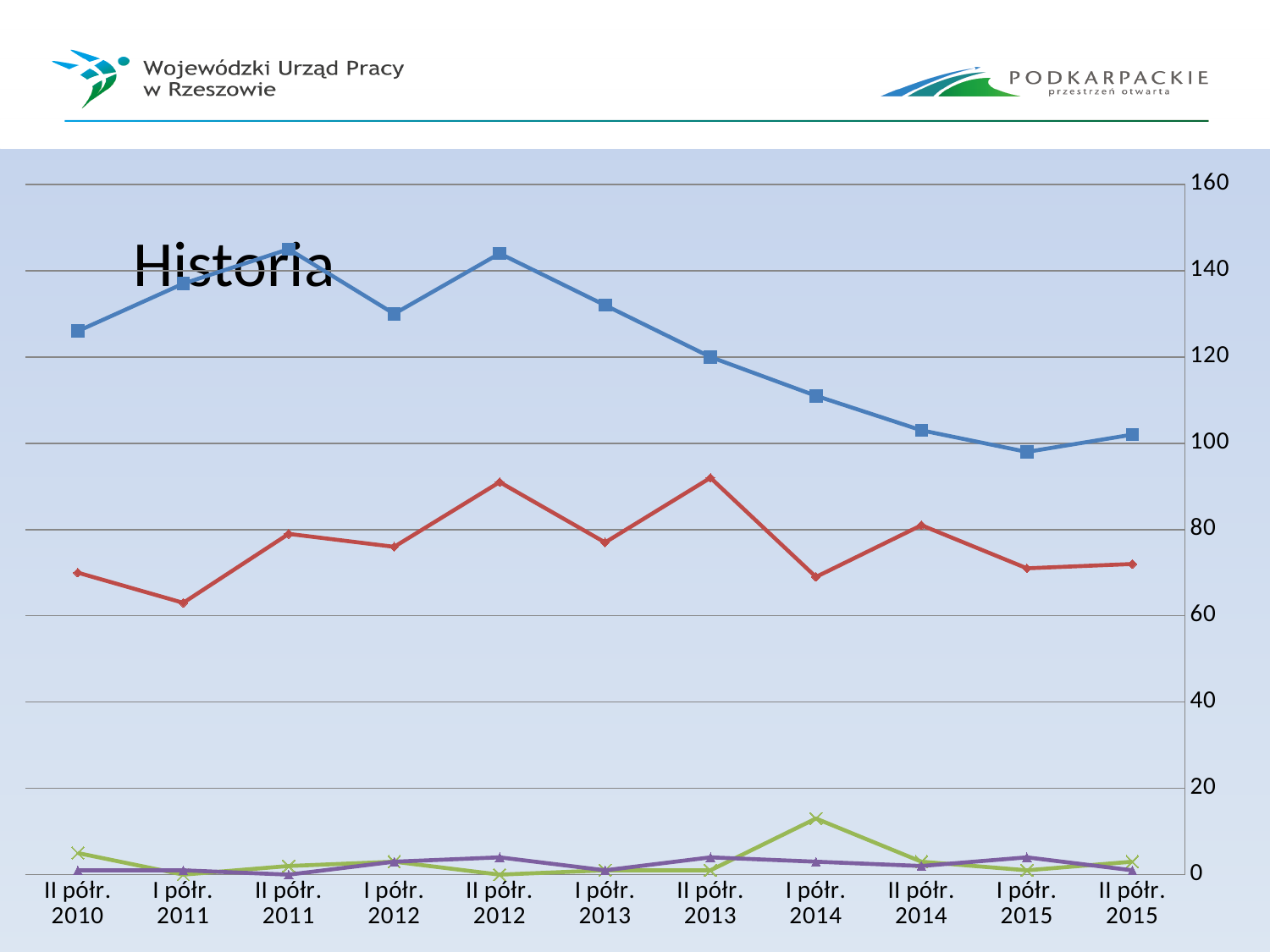
Is the value of the blue line for I półr. 2015 greater or less than 100? less How many periods are shown along the x axis of the chart? 11 How many lines are plotted on the chart? 4 Is the value of the blue line for II półr. 2010 greater or less than 120? greater Does the blue line rise or fall between II półr. 2012 and I półr. 2015? fall At which period does the blue line reach its lowest value? I półr. 2015 At which period does the green line reach its highest value? I półr. 2014 Is the value of the green line for I półr. 2014 greater or less than 20? less At which period does the red line reach its lowest value? I półr. 2011 What is the title of the chart? Historia What kind of chart is shown on the slide? line chart